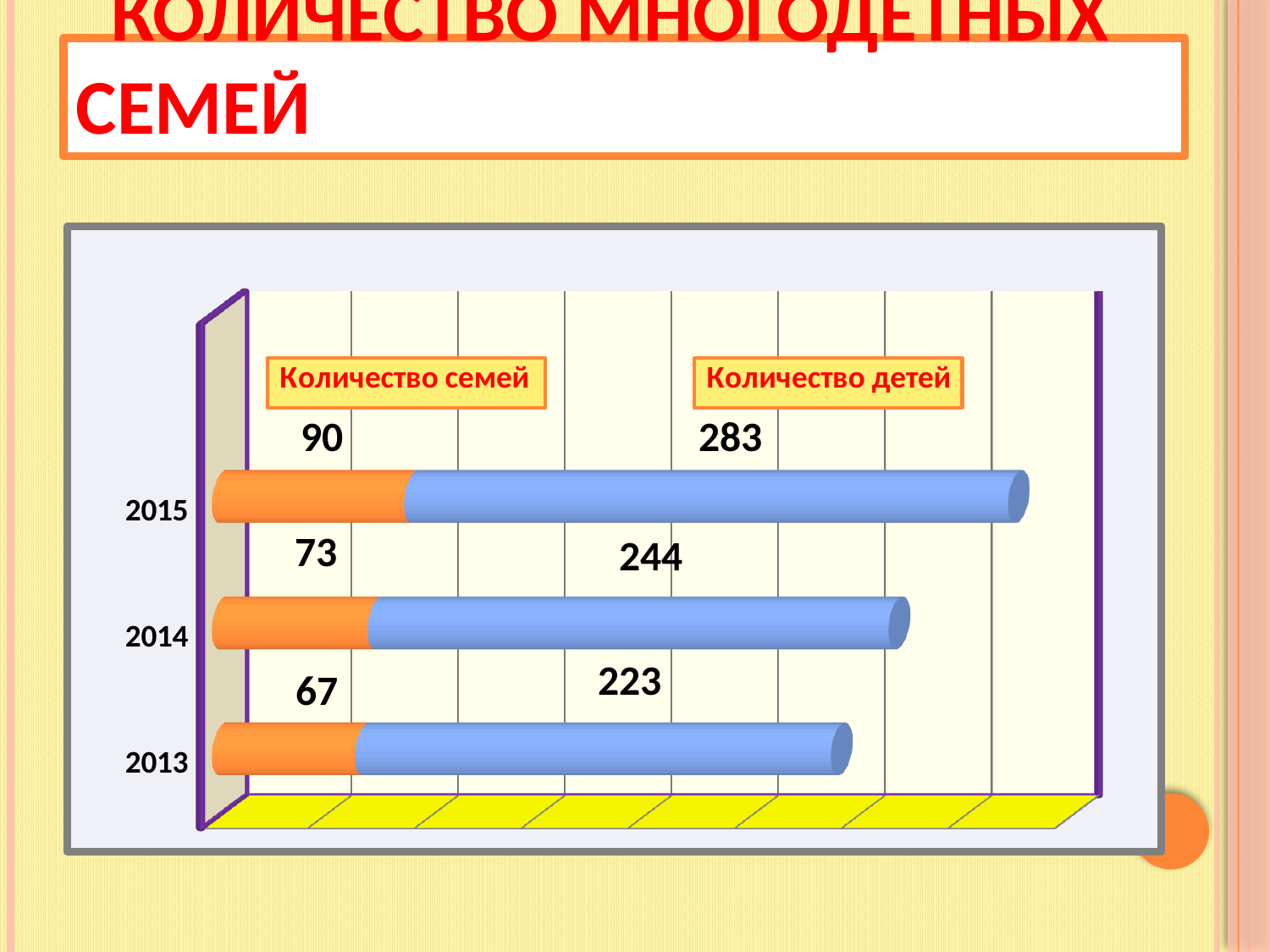
What is the value for Количество семей in 2015? 90 What is the value for Количество семей in 2013? 67 How many years are shown on the chart? 3 What is the value for Количество детей in 2014? 244 What kind of chart is shown on the slide? Stacked bar chart What is the value for Количество детей in 2013? 223 Which year has the lowest value for Количество семей? 2013 What is the difference between Количество детей in 2015 and in 2013? 60 Which is larger: Количество семей in 2014 or in 2013? 2014 Which year has the highest value for Количество детей? 2015 What is the total of the stacked bar for 2014? 317 How many series does the legend list? 2